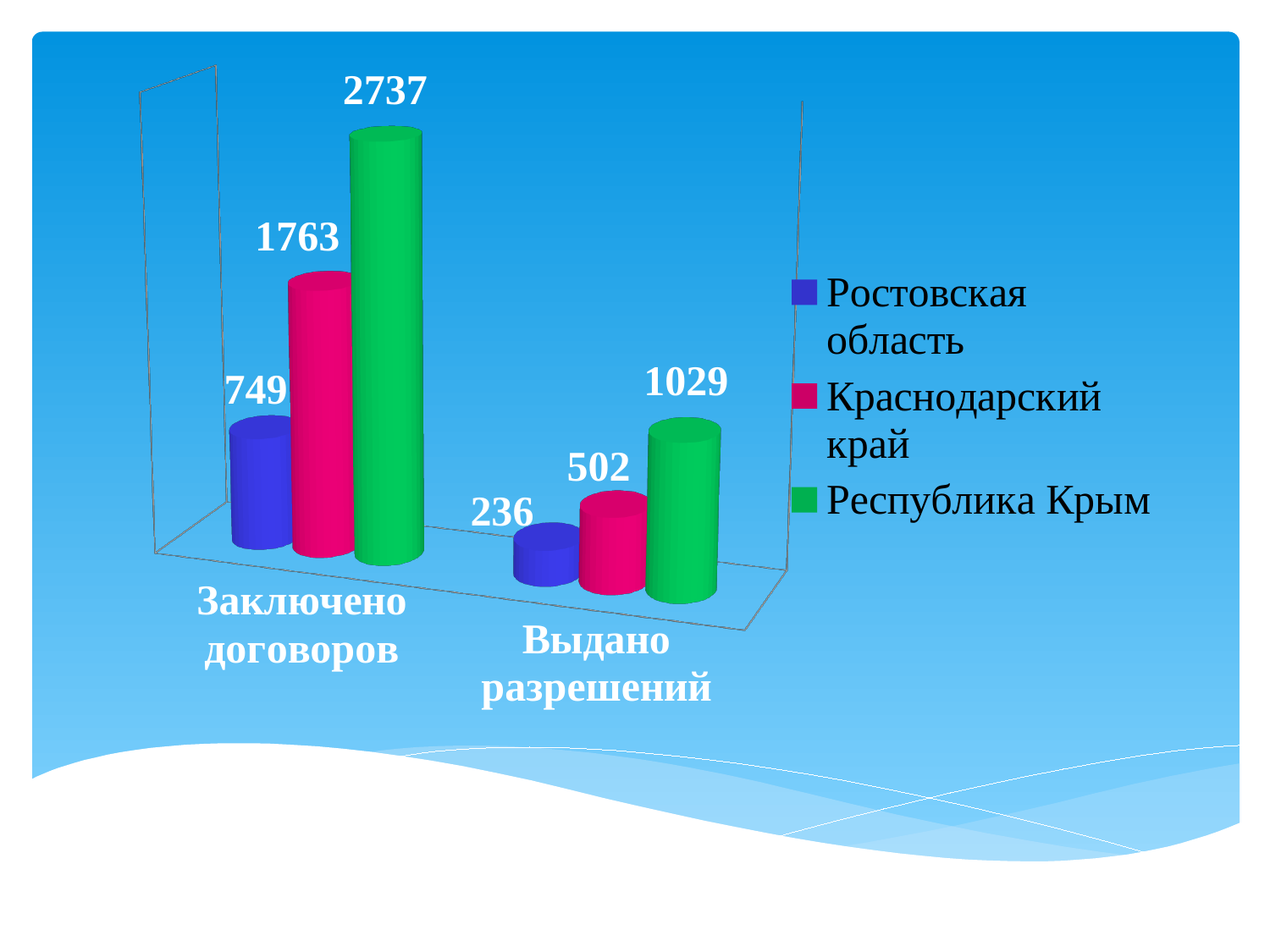
What is the value for Республика Крым in the Выдано разрешений category? 1029 What is the difference between Республика Крым and Краснодарский край in the Заключено договоров category? 974 How many series does the legend list? 3 What is the difference between Краснодарский край and Ростовская область in the Выдано разрешений category? 266 Which series has the highest value in the Заключено договоров category? Республика Крым Which series has the lowest value in the Выдано разрешений category? Ростовская область What is the value for Ростовская область in the Выдано разрешений category? 236 What kind of chart is shown on the slide? Bar chart What is the value for Краснодарский край in the Заключено договоров category? 1763 What is the value for Ростовская область in the Заключено договоров category? 749 Which is larger: Краснодарский край for Заключено договоров or Республика Крым for Выдано разрешений? Краснодарский край for Заключено договоров How many categories are shown on the x axis? 2